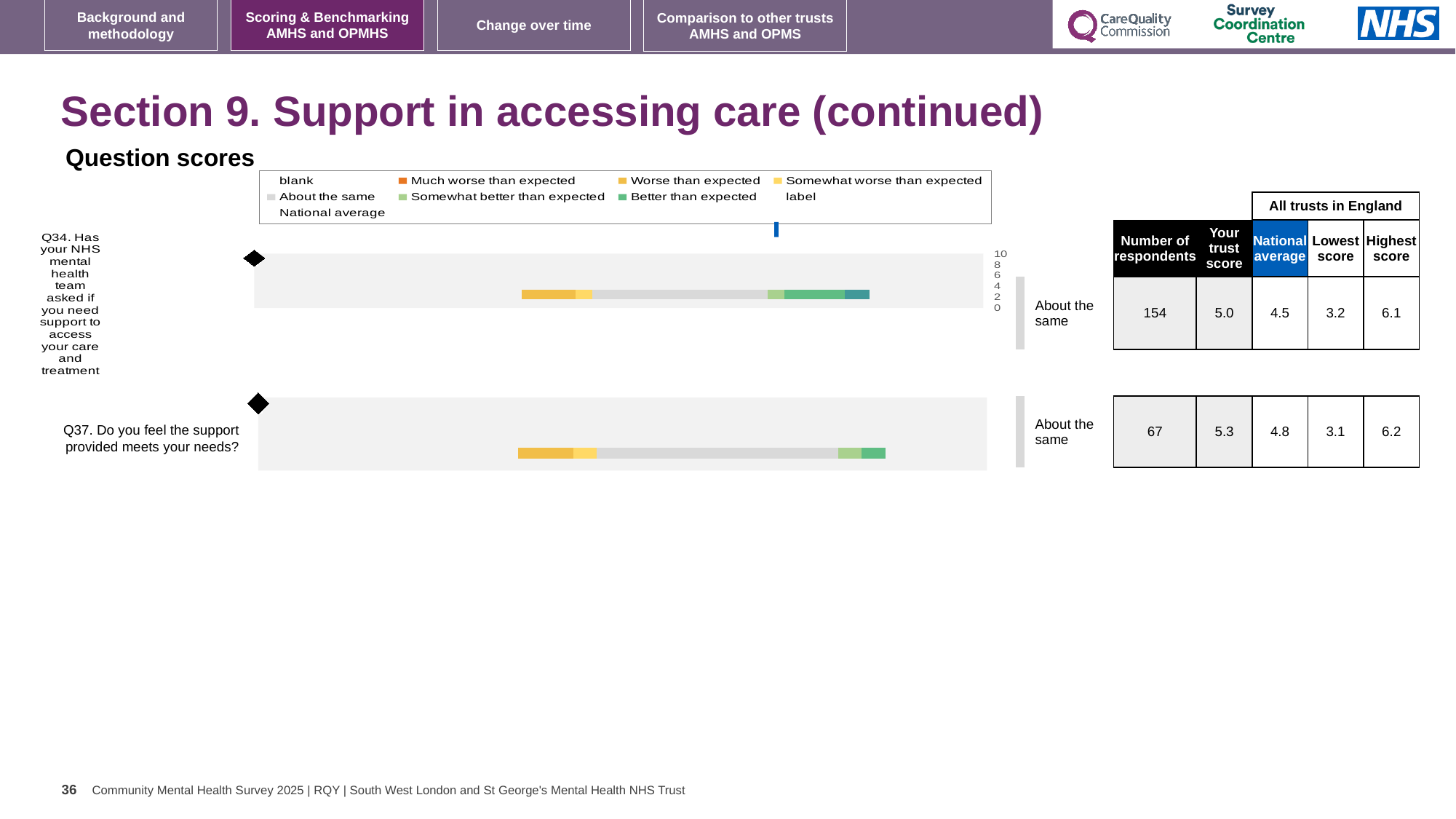
What is the national average for Q37 in the table beside the chart? 4.8 Which question has more respondents, Q34 or Q37? Q34 What benchmark category is shown next to the bar for Q34? About the same How many respondents are listed for Q34 in the table beside the chart? 154 By how much does the trust score for Q34 exceed the national average for Q34? 0.5 Which question has the higher trust score, Q34 or Q37? Q37 What benchmark category is shown next to the bar for Q37? About the same In the legend of the question scores chart, which colour represents 'Much worse than expected'? orange What is the trust score for Q34 in the table beside the chart? 5.0 What is the difference between the highest score and the lowest score for Q37? 3.1 How many questions are plotted in the question scores chart? 2 What type of chart is used to show the question scores for Q34 and Q37? bar chart